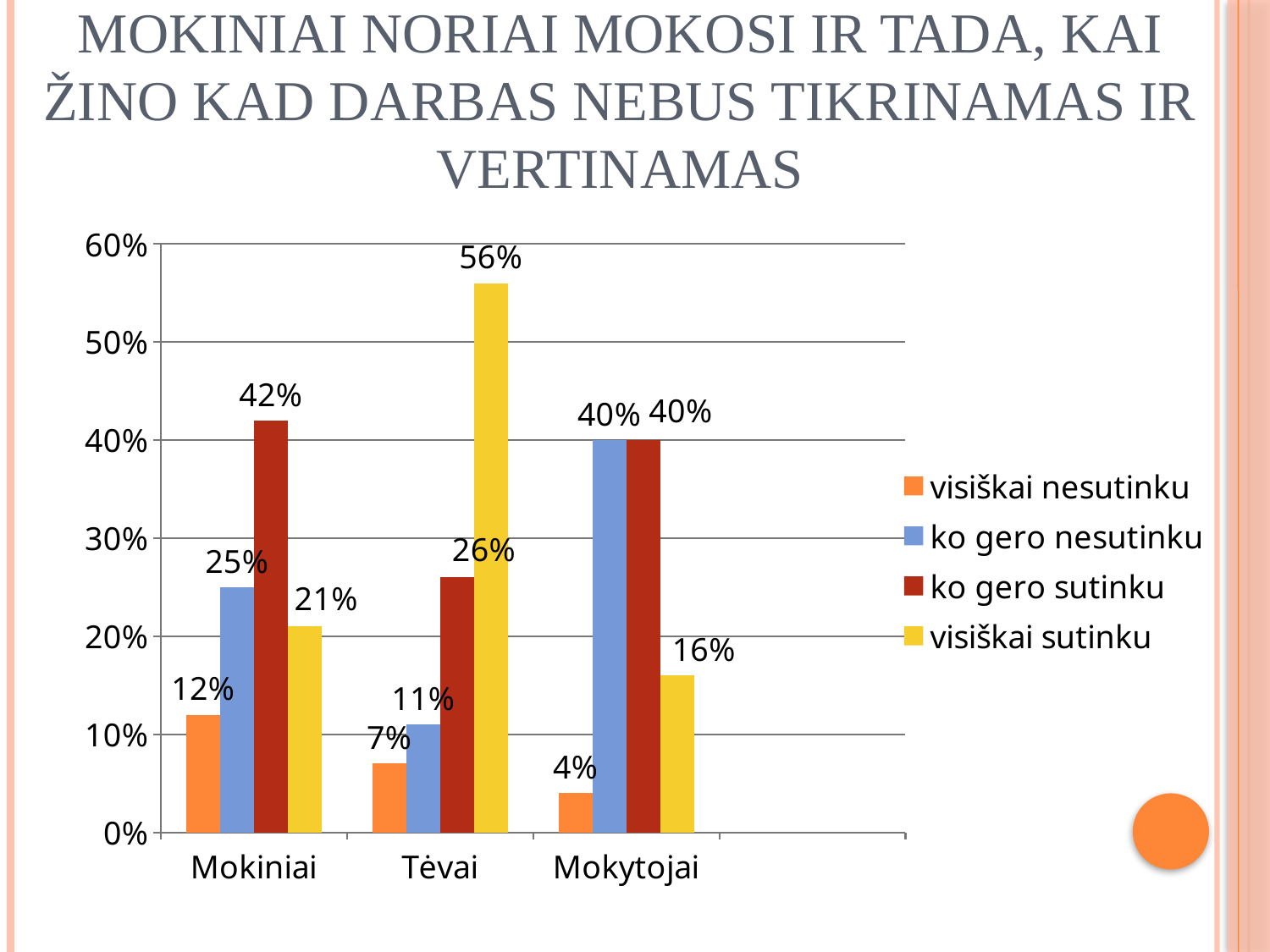
How many series does the legend list? 4 What kind of chart is shown on the slide? Bar chart Which category has the highest value for "visiškai sutinku"? Tėvai What is the difference between the "visiškai sutinku" values for Tėvai and Mokytojai? 40% What is the value for "ko gero sutinku" in the Mokiniai category? 42% How many categories are shown on the x axis? 3 What is the value for "ko gero nesutinku" in the Tėvai category? 11% What is the value for "visiškai nesutinku" in the Mokytojai category? 4% Which is larger: "ko gero nesutinku" for Mokiniai or "ko gero nesutinku" for Mokytojai? Mokytojai Which category has the lowest value for "visiškai nesutinku"? Mokytojai Which colour represents the "visiškai sutinku" series? Yellow What is the value for "visiškai sutinku" in the Tėvai category? 56%